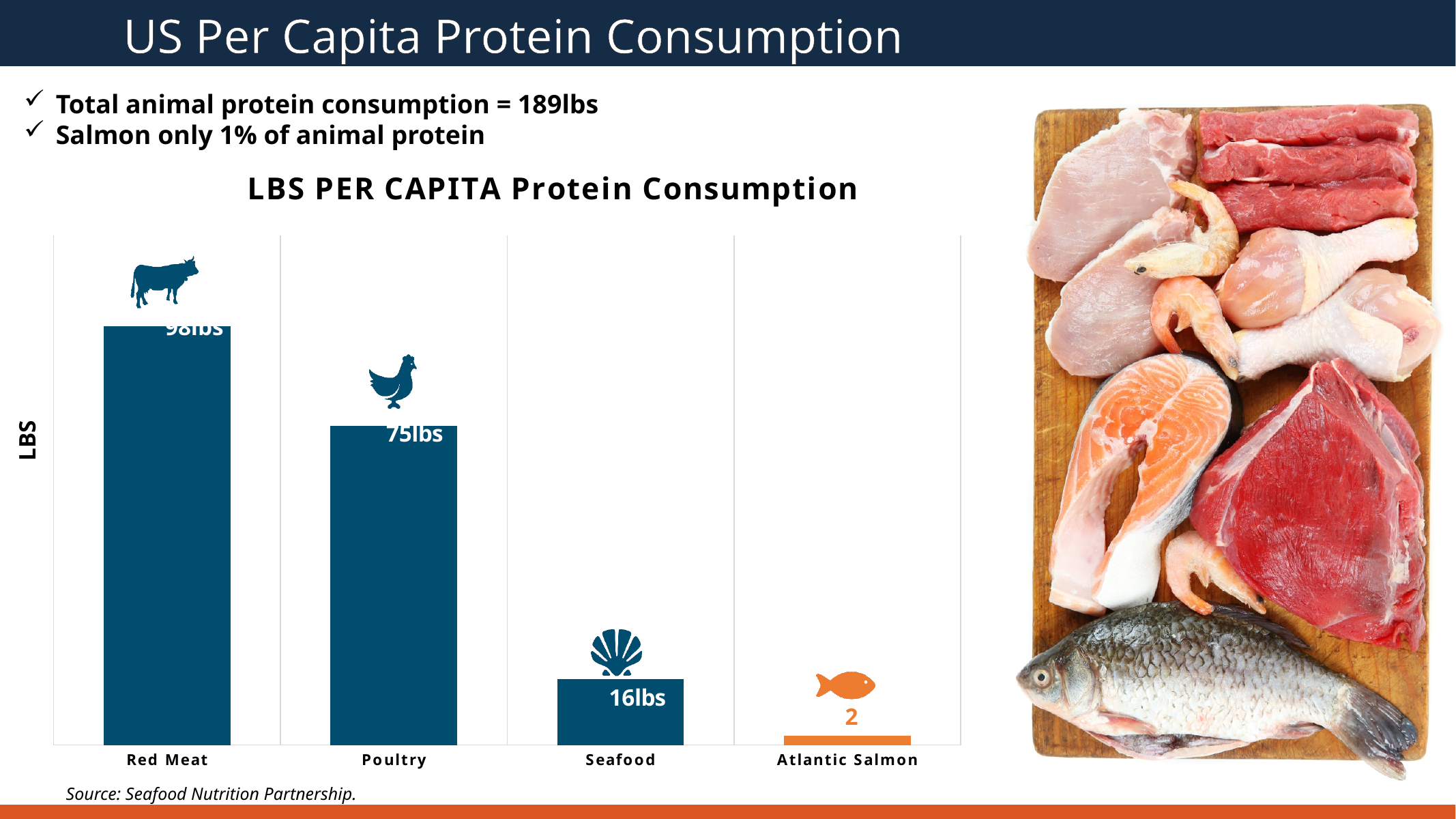
Do the values rise or fall from left to right across the categories? Fall What is the value for Atlantic Salmon? 2 What is the value for Red Meat? 98lbs Which category has the highest value? Red Meat Which category has the lowest value? Atlantic Salmon How many categories are shown in the chart? 4 What is the value for Poultry? 75lbs What is the difference between the Poultry and Seafood values? 59lbs Which is larger, the value for Poultry or the value for Seafood? Poultry What type of chart is shown on the slide? Bar chart What is the title of the chart? LBS PER CAPITA Protein Consumption What is the value for Seafood? 16lbs